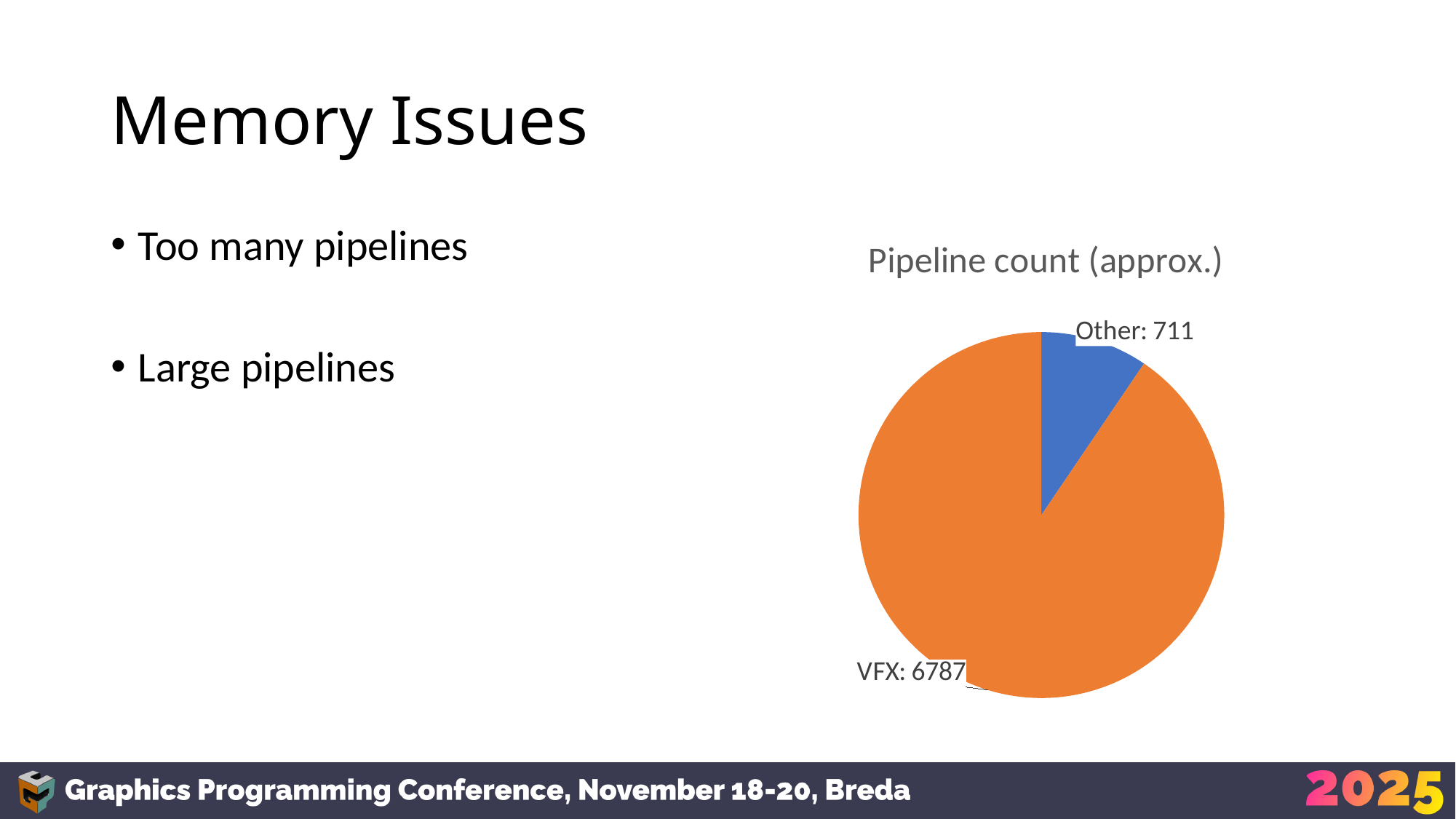
What is the pipeline count for VFX? 6787 What is the total pipeline count across both slices? 7498 Which category has the largest slice of the pie? VFX How many slices does the pie chart have? 2 What colour is the VFX slice? orange Which is larger, the pipeline count for VFX or for Other? VFX What is the difference between the VFX and Other pipeline counts? 6076 What is the title of the chart? Pipeline count (approx.) What is the pipeline count for Other? 711 What type of chart is shown on the slide? pie chart Which category has the smallest slice of the pie? Other